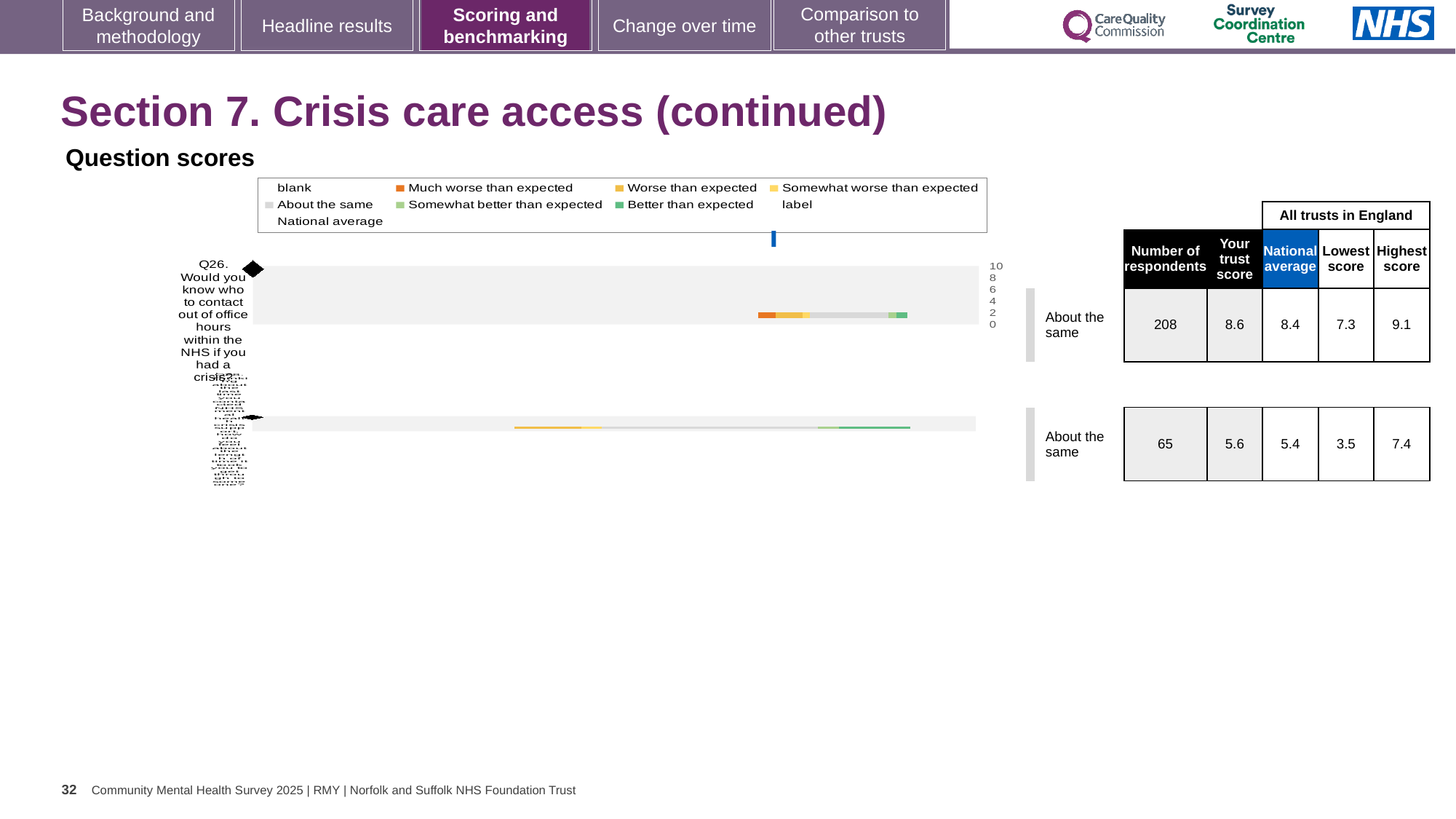
For Q26 in the question scores chart, what benchmark category is the trust's result labelled as? About the same For Q26 in the question scores chart, which is larger: your trust score or the national average? Your trust score For Q26 in the question scores chart, what is the number of respondents? 208 For Q26 in the question scores chart, what is the difference between the highest score and the lowest score? 1.8 In the question scores chart legend, what colour represents 'Much worse than expected'? orange How many question rows are plotted in the question scores chart? 2 For Q26 in the question scores chart, what is the national average? 8.4 For Q26 in the question scores chart, what is the lowest score among all trusts in England? 7.3 For Q26 in the question scores chart, what is your trust score? 8.6 What kind of chart is used to show the question scores on this slide? bar chart In the question scores chart legend, what colour represents 'Better than expected'? green For Q26 in the question scores chart, what is the highest score among all trusts in England? 9.1